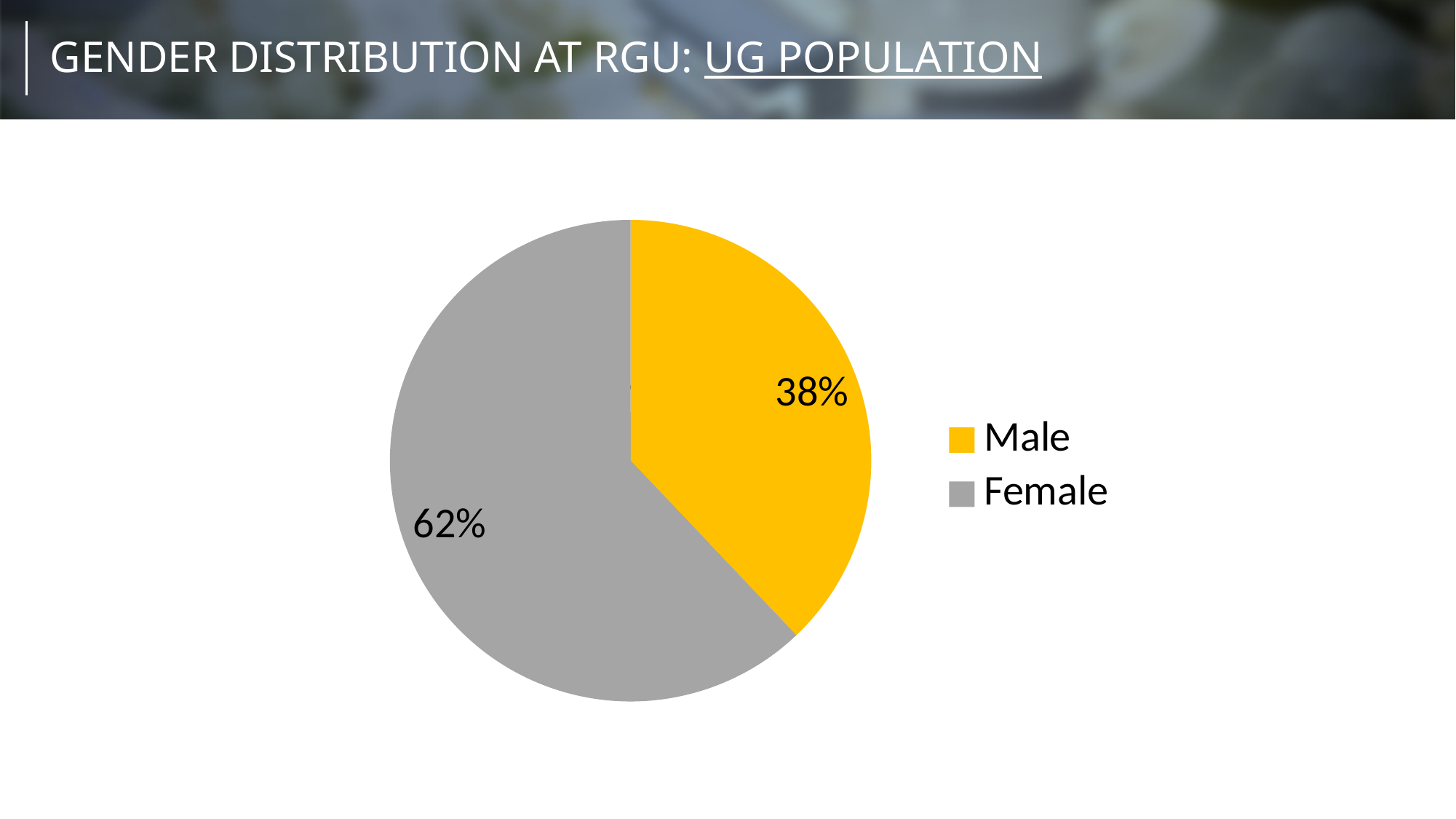
What colour represents Male in the pie chart? yellow How many categories does the pie chart show? 2 What share of the UG population is Male? 38% What is the difference in percentage points between the Female and Male shares? 24 Which is larger, the Male share or the Female share? Female Which category has the largest slice of the pie? Female How many entries does the legend list? 2 What kind of chart is shown on the slide? pie chart What share of the UG population is Female? 62% What is the title of the slide? GENDER DISTRIBUTION AT RGU: UG POPULATION Which category has the smallest slice of the pie? Male